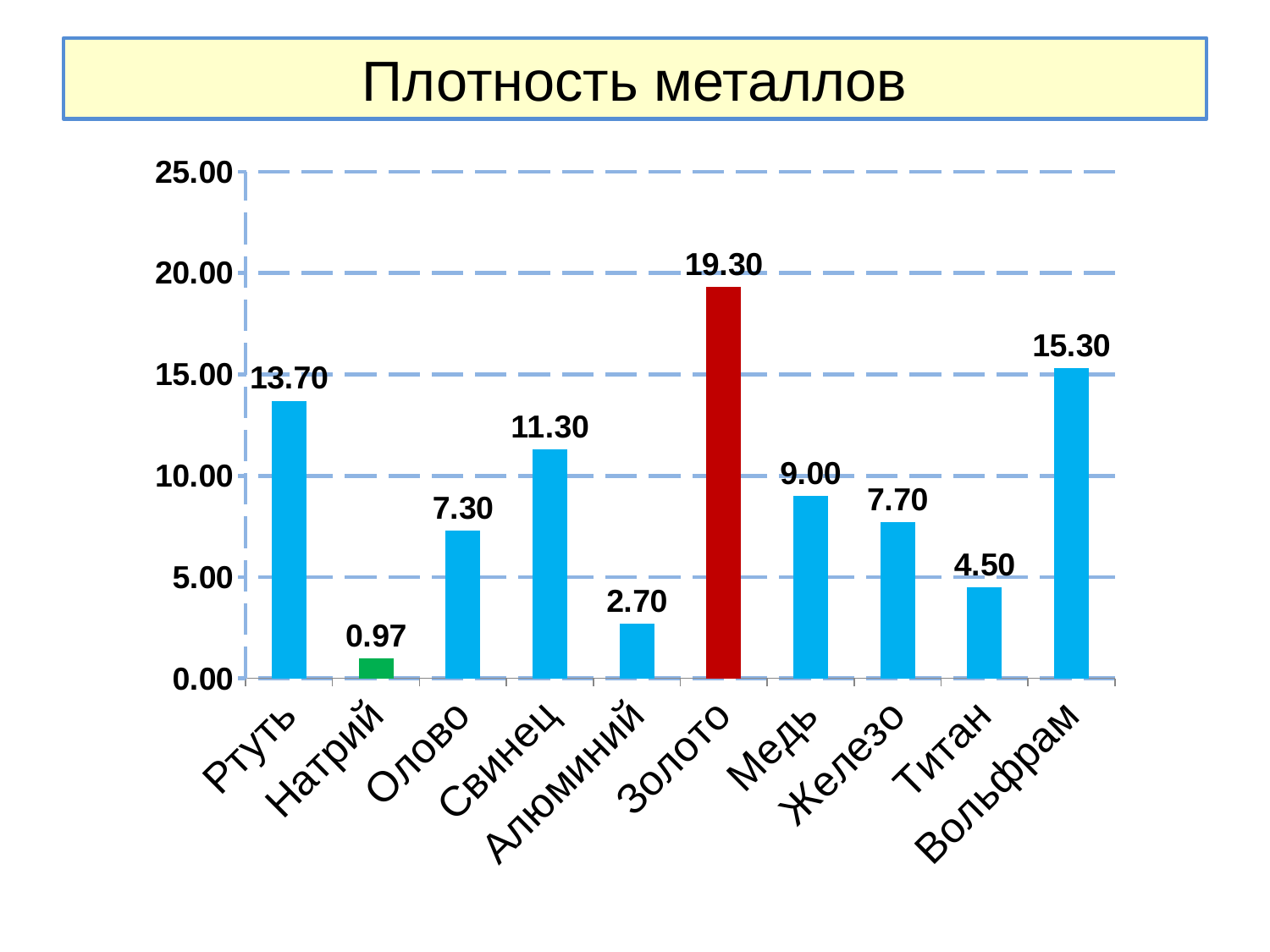
What is the difference between the values for Ртуть and Свинец? 2.40 What is the value for Золото? 19.30 Which category has the highest value? Золото What is the title of the slide? Плотность металлов What is the value for Натрий? 0.97 What is the difference between the values for Золото and Вольфрам? 4.00 Which category has the lowest value? Натрий Which is larger, the value for Медь or the value for Железо? Медь Is the value for Титан greater or less than 5.00? less What kind of chart is shown on the slide? bar chart What is the value for Вольфрам? 15.30 How many categories are shown on the x axis? 10